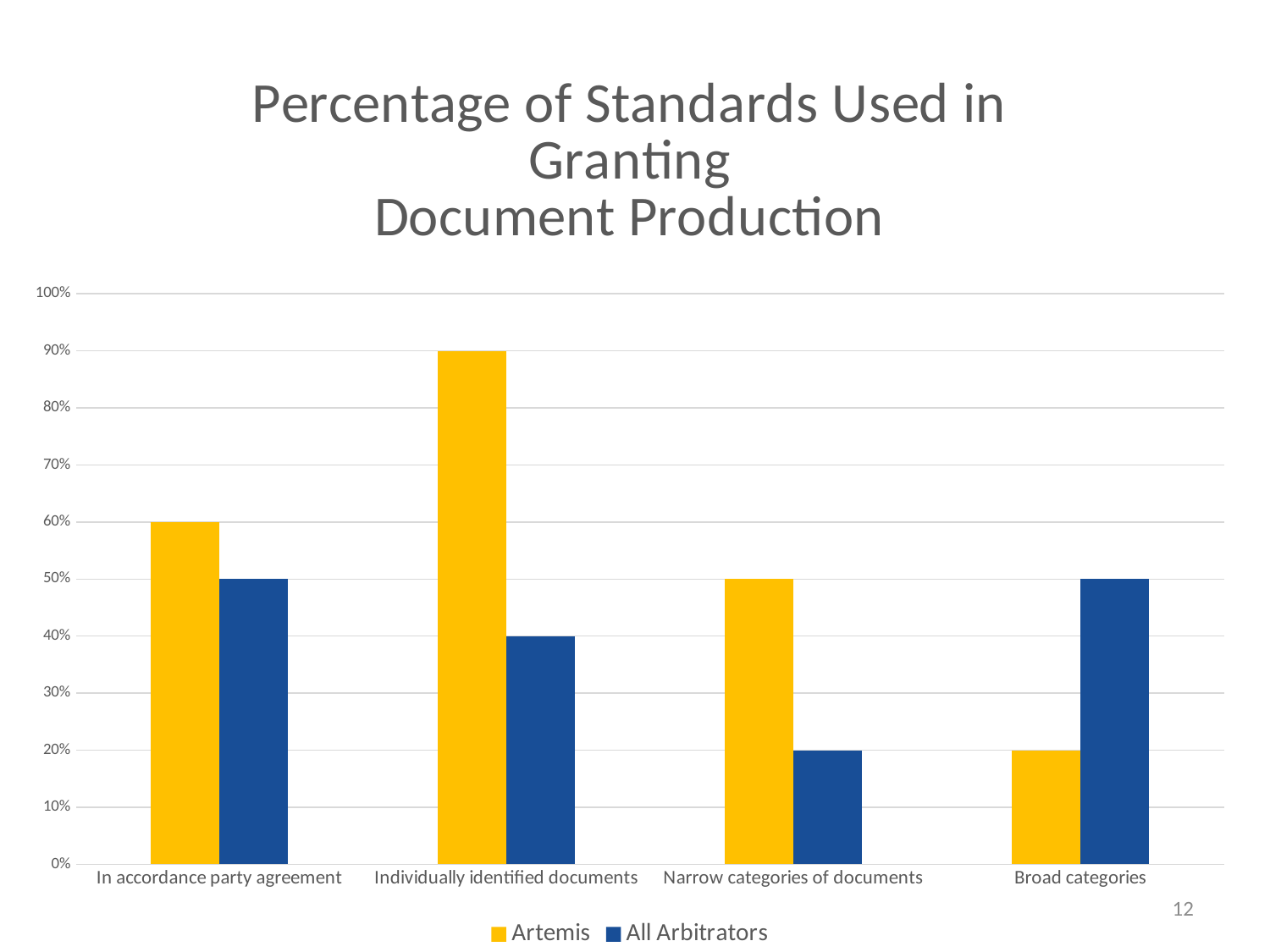
Which category has the highest Artemis value? Individually identified documents Is the Artemis value for In accordance party agreement greater or less than 50%? greater How many categories are shown on the x axis? 4 What is the Artemis value for Individually identified documents? 90% Which colour represents the All Arbitrators series? blue What is the All Arbitrators value for Narrow categories of documents? 20% For Broad categories, which series has the larger value, Artemis or All Arbitrators? All Arbitrators What kind of chart is shown on the slide? bar chart What is the Artemis value for Broad categories? 20% How many series does the legend list? 2 Which category has the lowest All Arbitrators value? Narrow categories of documents What is the difference between the Artemis and All Arbitrators values for Individually identified documents? 50%